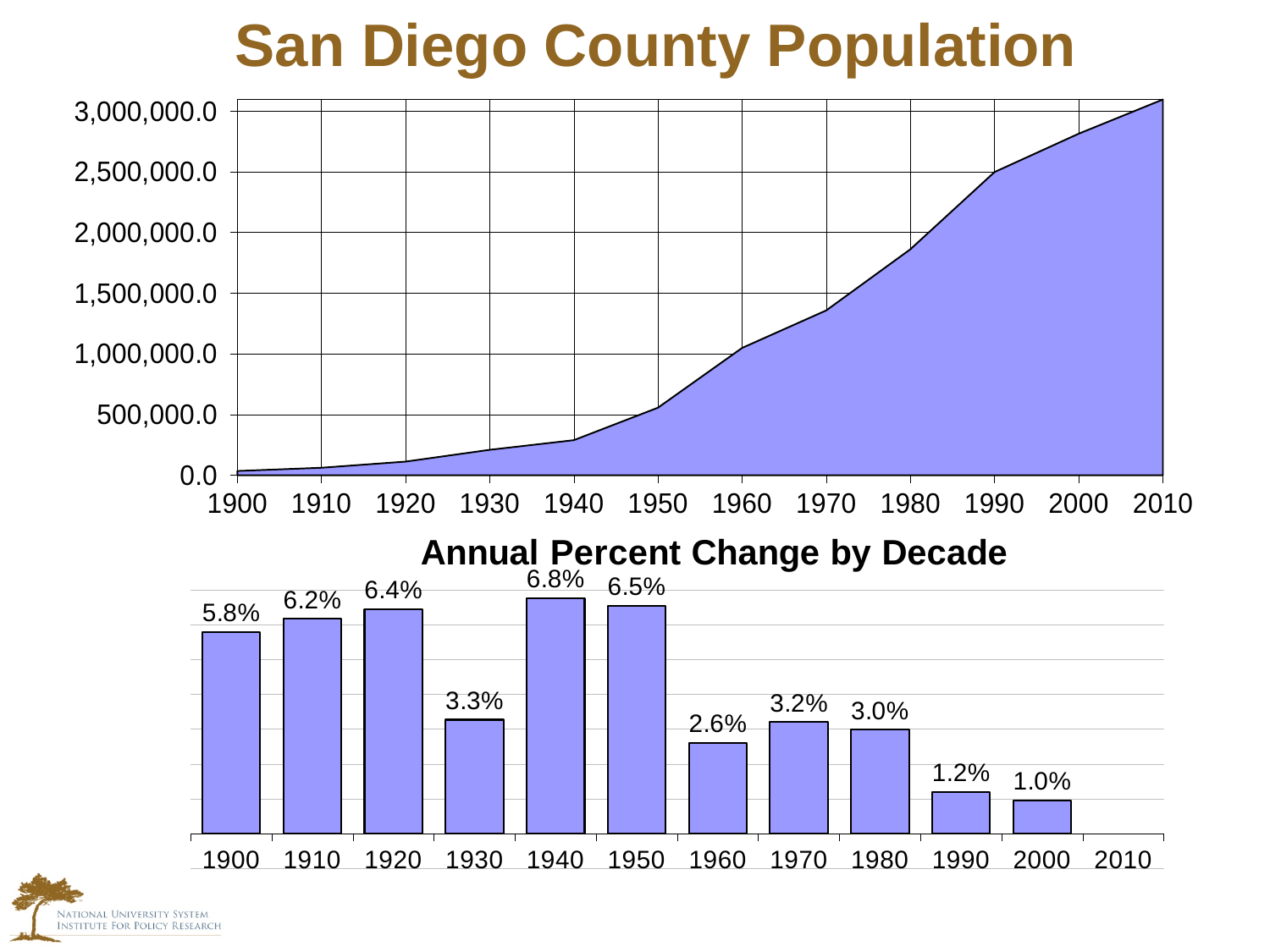
In the Annual Percent Change by Decade chart, which is larger, the value for 1930 or the value for 1970? 1930 What kind of chart is the Annual Percent Change by Decade chart? bar chart In the Annual Percent Change by Decade chart, which decade has the highest annual percent change? 1940 In the Annual Percent Change by Decade chart, how many bars are plotted? 11 In the San Diego County Population chart, is the value for 1980 greater or less than 1,500,000? greater What is the title of the top chart on the slide? San Diego County Population In the Annual Percent Change by Decade chart, which decade has the lowest annual percent change? 2000 In the Annual Percent Change by Decade chart, what is the value for 1960? 2.6% In the Annual Percent Change by Decade chart, what is the difference between the values for 1950 and 1960? 3.9% In the Annual Percent Change by Decade chart, what is the value for 1940? 6.8% In the San Diego County Population chart, is the value for 1940 greater or less than 500,000? less In the San Diego County Population chart, do the values rise or fall from 1900 to 2010? rise